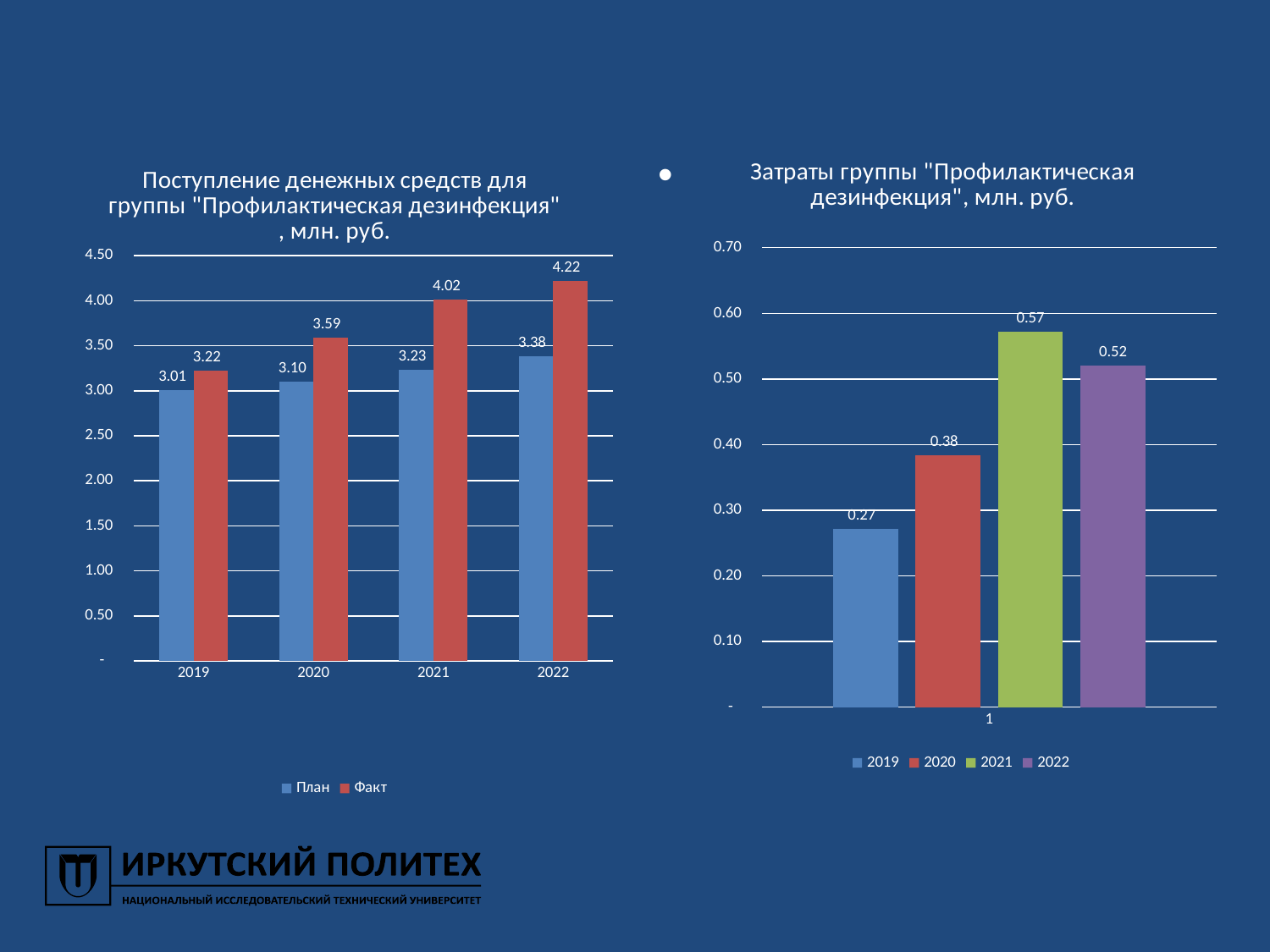
In the right chart (Затраты группы), which is larger, the value for 2021 or the value for 2022? 2021 In the left chart (Поступление денежных средств), what is the difference between Факт and План in 2022? 0.84 In the right chart (Затраты группы), what is the difference between the 2021 and 2019 values? 0.30 In the right chart (Затраты группы), what is the value for 2020? 0.38 In the left chart (Поступление денежных средств), what is the План value for 2019? 3.01 What type of chart is the right chart (Затраты группы)? bar chart In the left chart (Поступление денежных средств), how many series does the legend list? 2 In the left chart (Поступление денежных средств), does the Факт value rise or fall from 2019 to 2022? rise In the left chart (Поступление денежных средств), which year has the highest Факт value? 2022 In the left chart (Поступление денежных средств), how many years are shown on the x axis? 4 In the left chart (Поступление денежных средств), what is the Факт value for 2021? 4.02 In the right chart (Затраты группы), which year has the lowest value? 2019